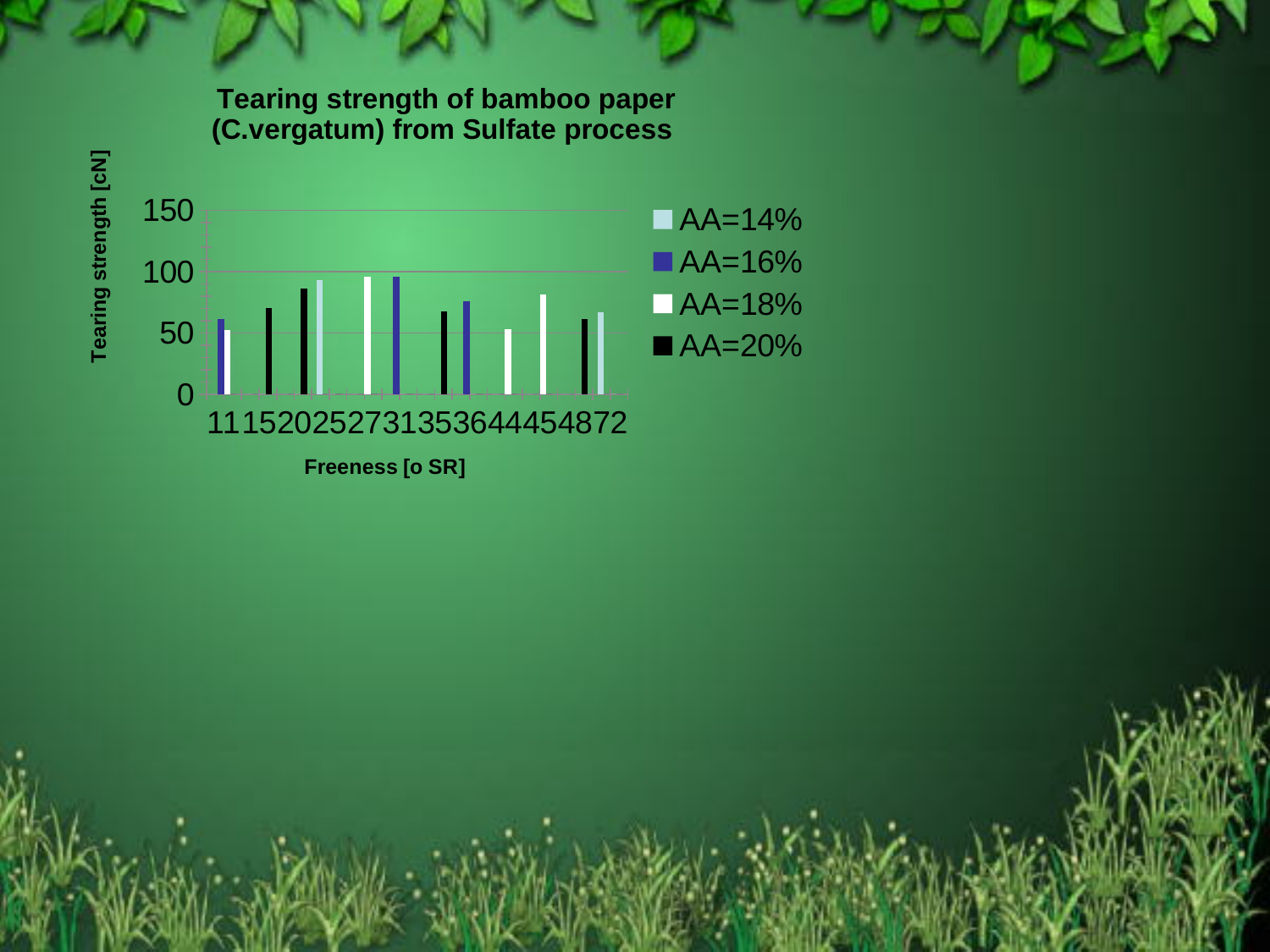
How many series does the legend list? 4 What kind of chart is shown on the slide? bar chart Is the AA=16% value at freeness 36 greater or less than 50? greater How many freeness categories are shown on the x axis? 12 What is the label of the y axis? Tearing strength [cN] Is the AA=14% value at freeness 72 greater or less than 100? less What is the title of the chart? Tearing strength of bamboo paper (C.vergatum) from Sulfate process Is the AA=20% value at freeness 15 greater or less than 50? greater Which is larger, the AA=20% value at freeness 20 or the AA=20% value at freeness 48? freeness 20